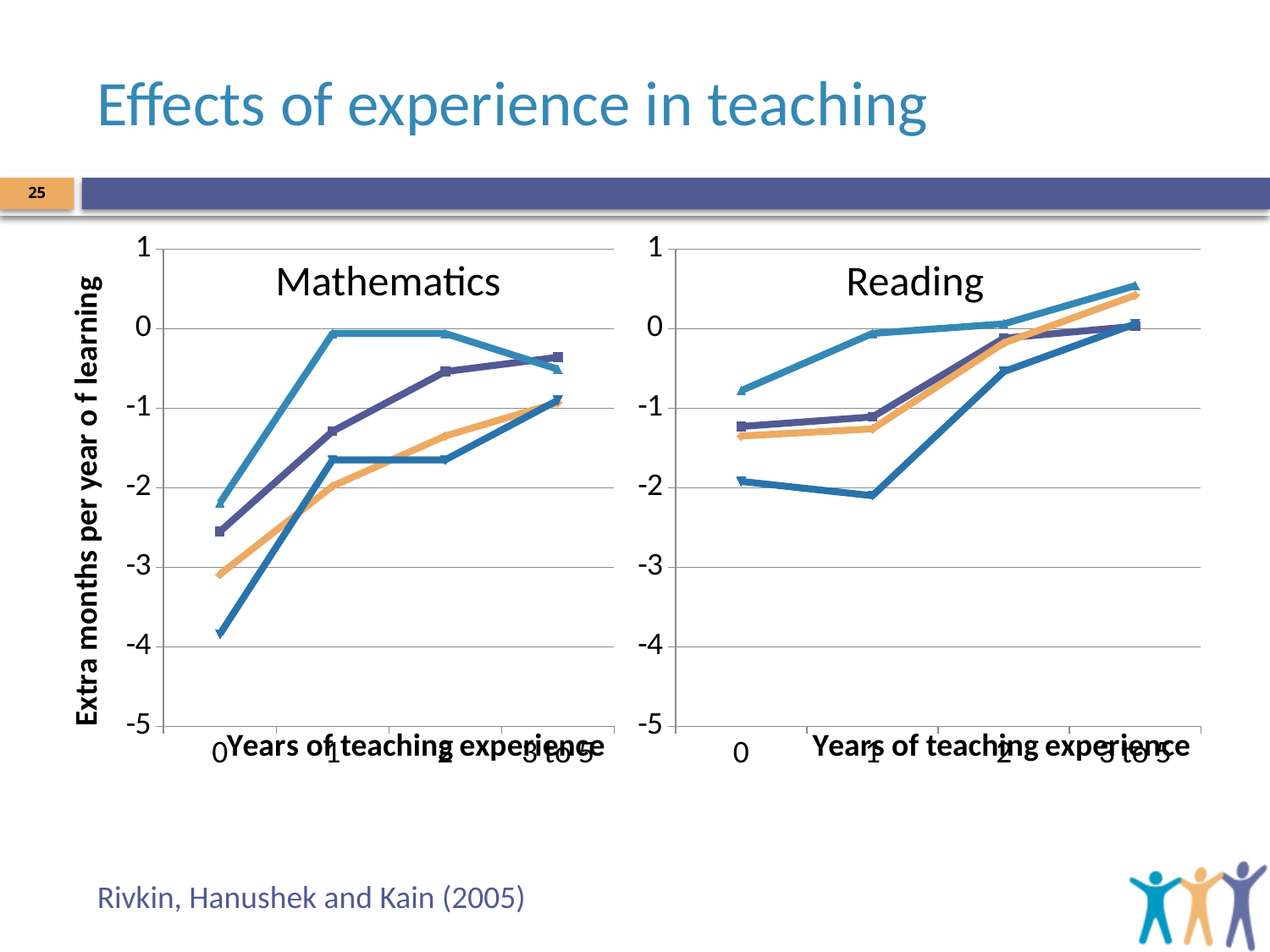
How many points are on the x axis of the Reading chart? 4 In the Reading chart, is the value of the orange line at 3 to 5 years of experience greater or less than 0? greater What is the label on the vertical axis of the Mathematics chart? Extra months per year of learning In the Mathematics chart, which line has the lowest value at 0 years of experience? the dark blue line In the Mathematics chart, is the value of the dark blue line at 0 years of experience greater or less than -3? less How many lines are plotted on the Mathematics chart? 4 In the Reading chart, does the orange line rise or fall from 0 years to 3 to 5 years of experience? rise In the Reading chart, at 0 years of experience, which is higher: the light blue line or the dark blue line? the light blue line What kind of chart is the Mathematics chart? line chart In the Reading chart, is the value of the light blue line at 0 years of experience greater or less than -1? greater In the Mathematics chart, do the lines rise or fall as years of teaching experience increase from 0 to 3 to 5? rise